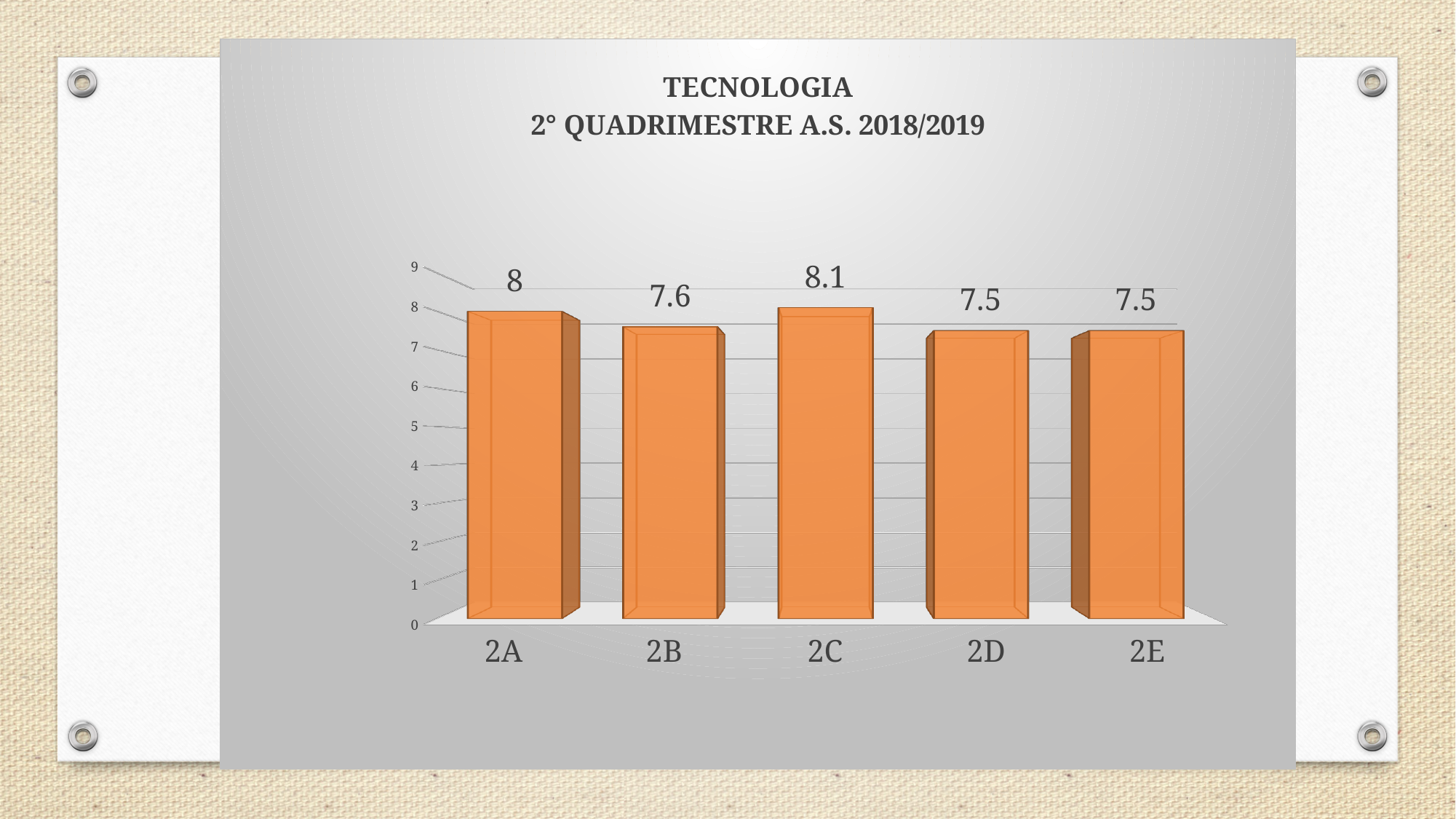
What is the value for 2D? 7.5 What is the difference between the values for 2A and 2E? 0.5 Is the value for 2C greater or less than 8? greater Which class has the highest value? 2C What is the value for 2C? 8.1 What is the value for 2B? 7.6 What is the difference between the values for 2C and 2B? 0.5 What is the title of the chart? TECNOLOGIA 2° QUADRIMESTRE A.S. 2018/2019 How many classes are shown on the chart? 5 Which is larger, the value for 2A or the value for 2B? 2A What kind of chart is shown on the slide? bar chart What is the value for 2A? 8